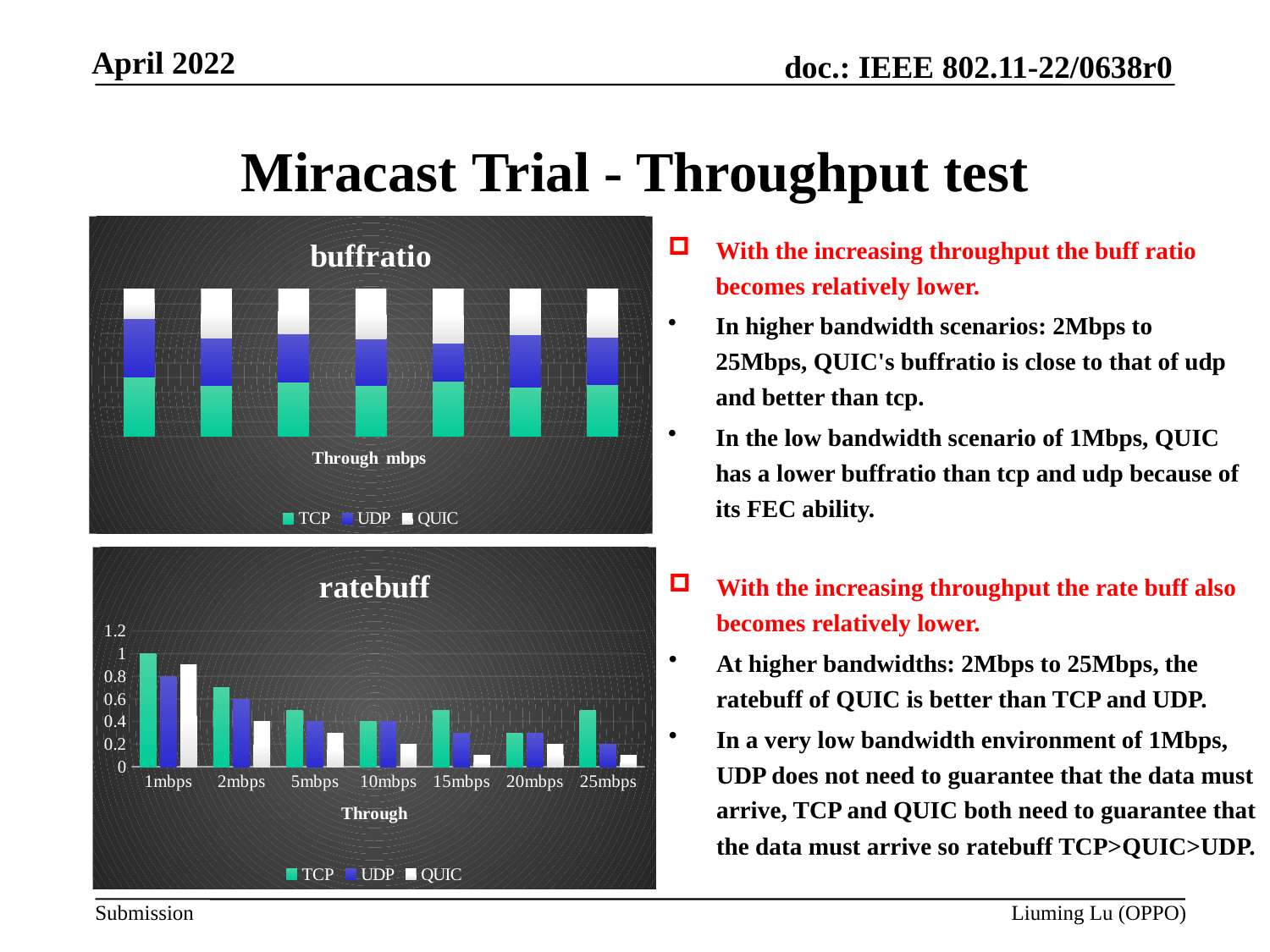
In the ratebuff chart, is the value for QUIC at 1mbps greater or less than 0.8? greater In the ratebuff chart, at which category is the TCP value highest? 1mbps In the ratebuff chart, at 1mbps, which is larger: TCP or UDP? TCP In the ratebuff chart, is the value for TCP at 25mbps greater or less than 0.4? greater In the ratebuff chart, at 2mbps, which is larger: UDP or QUIC? UDP What is the title of the top chart on the slide? buffratio In the ratebuff chart, do the QUIC values generally rise or fall from 1mbps to 25mbps? fall How many series does the legend of the buffratio chart list? 3 What kind of chart is the ratebuff chart? bar chart In the ratebuff chart, what is the value for TCP at 1mbps? 1 In the ratebuff chart, is the value for QUIC at 15mbps greater or less than 0.2? less How many categories are shown on the x axis of the ratebuff chart? 7